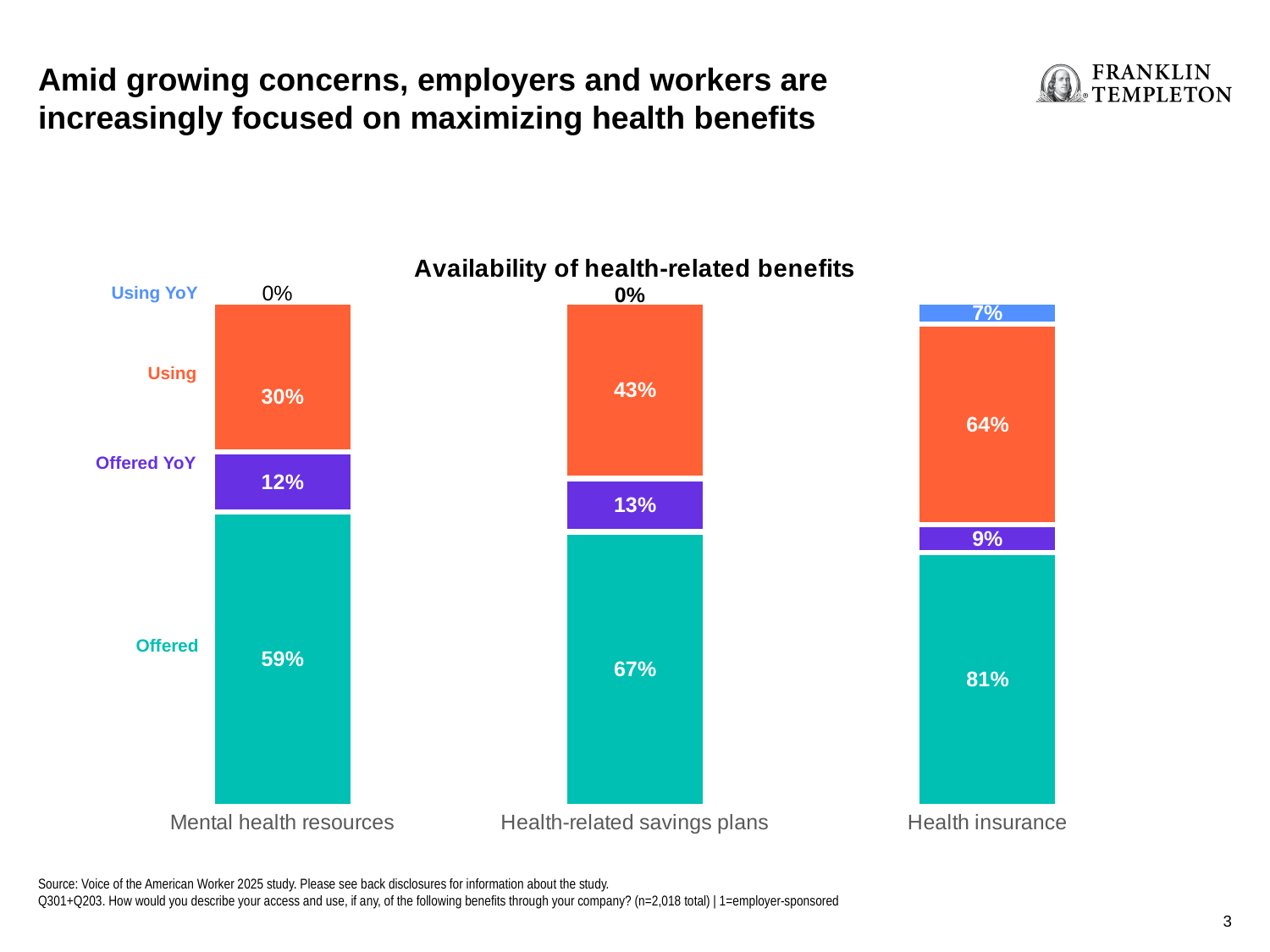
What is the Offered value for Health insurance? 81% What is the difference between the Offered values for Health insurance and Mental health resources? 22% What is the Using value for Health-related savings plans? 43% What is the Using YoY value for Health insurance? 7% How many categories are shown along the x axis of the chart? 3 What is the Offered YoY value for Mental health resources? 12% Which category has the highest Offered value? Health insurance Which is larger, the Offered YoY value for Health-related savings plans or for Health insurance? Health-related savings plans What is the title of the chart? Availability of health-related benefits What type of chart is shown on the slide? Stacked bar chart Which category has the lowest Using value? Mental health resources How many series are labelled on the chart (Offered, Offered YoY, Using, Using YoY)? 4